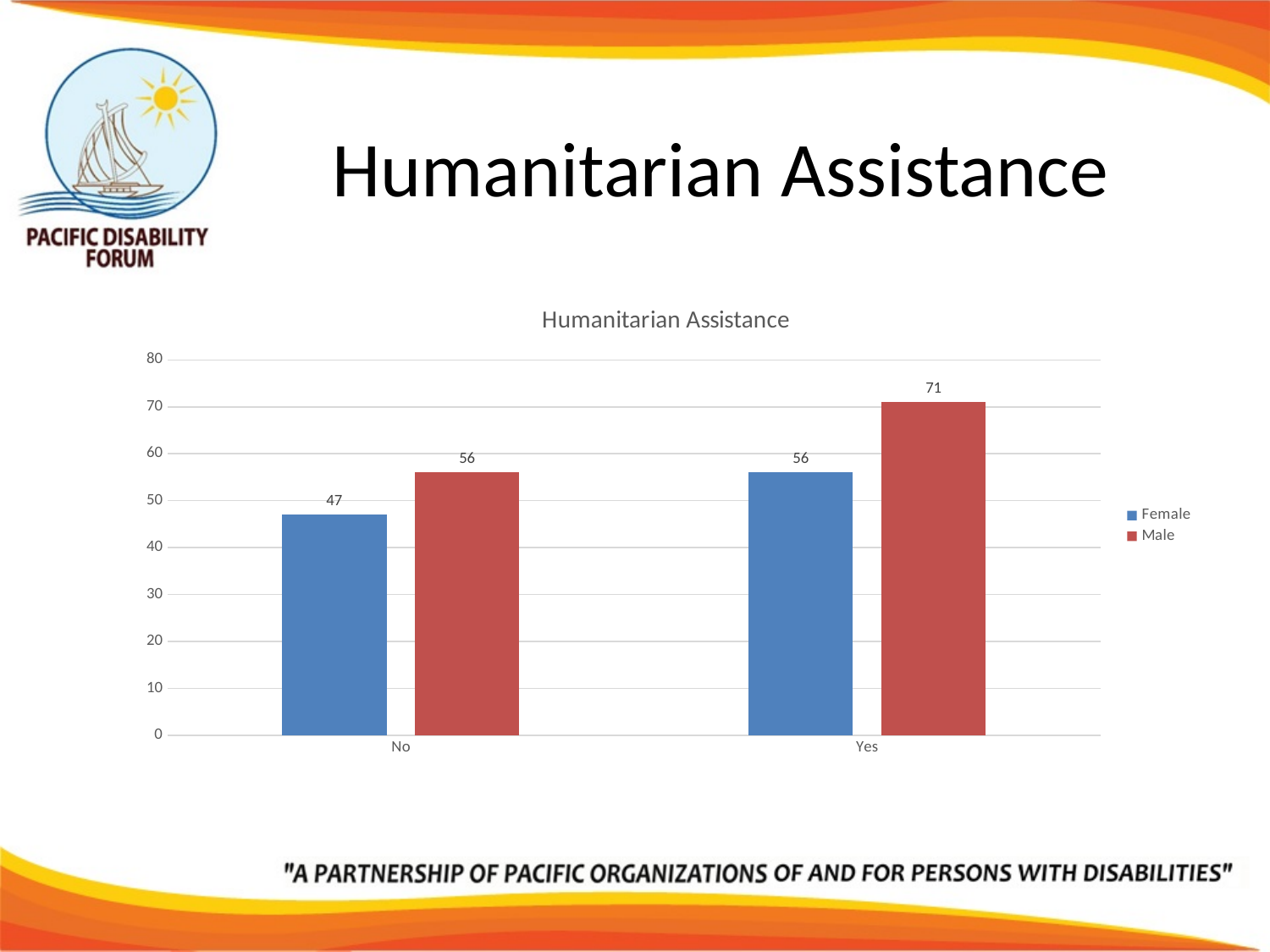
Which category has the lowest Female value? No What kind of chart is shown on the slide? Bar chart What is the Female value for the No category? 47 Which category has the highest Male value? Yes How many categories are shown on the x axis? 2 What is the difference between the Male and Female values for the No category? 9 What is the difference between the Male and Female values for the Yes category? 15 How many series does the legend list? 2 What is the Male value for the No category? 56 What is the Male value for the Yes category? 71 Which is larger, the Male value for Yes or the Male value for No? Male value for Yes What is the Female value for the Yes category? 56